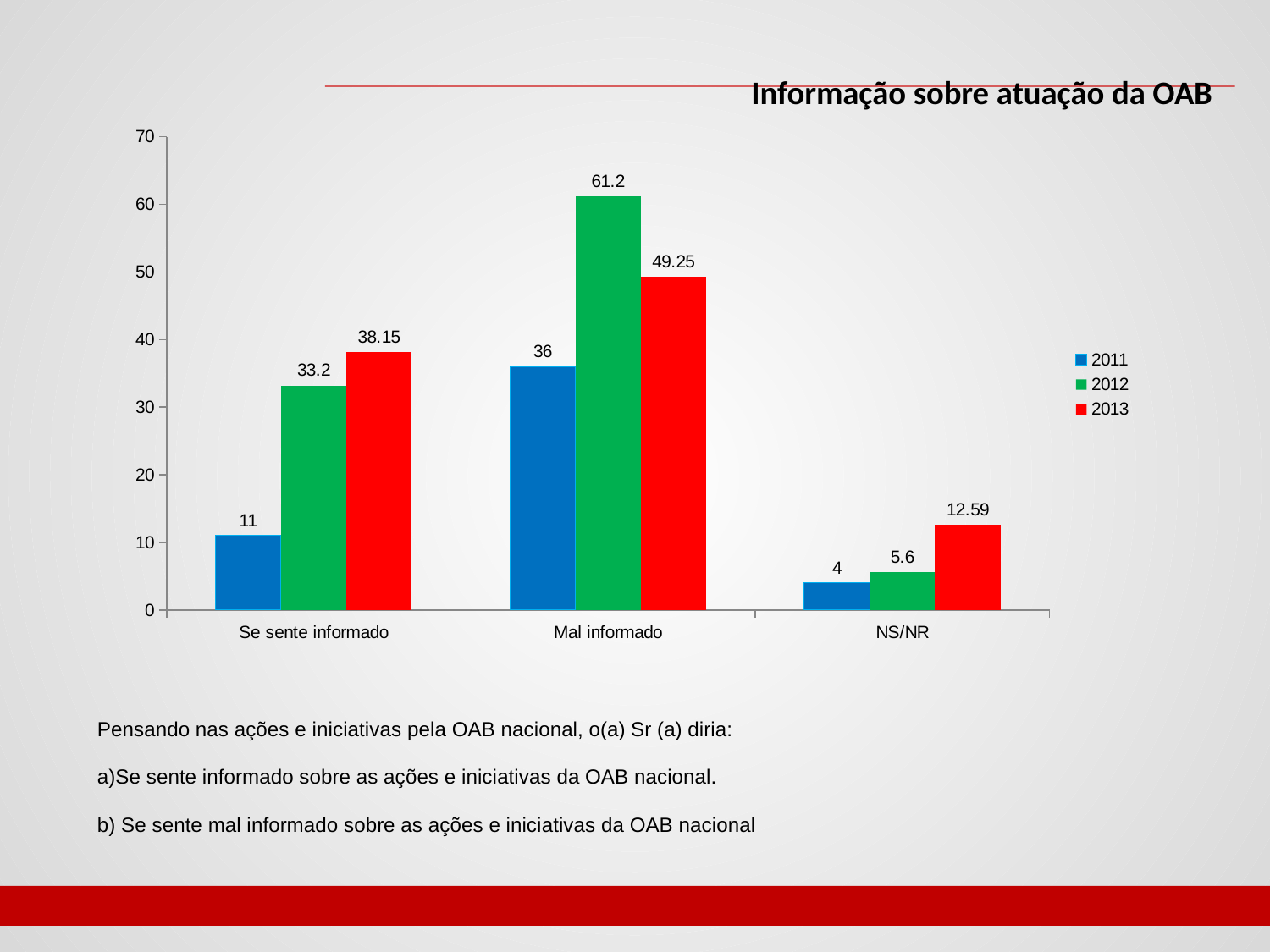
How many categories are shown on the x axis? 3 What kind of chart is shown on the slide? Bar chart Which is larger in the 'Se sente informado' category: the 2011 value or the 2012 value? 2012 Which category has the highest value for the 2011 series? Mal informado What is the difference between the 2012 and 2013 values in the 'Mal informado' category? 11.95 What is the value for 2011 in the 'NS/NR' category? 4 Which category has the lowest value for the 2013 series? NS/NR How many series does the legend list? 3 What is the title of the chart? Informação sobre atuação da OAB Is the value for 2013 in the 'NS/NR' category greater or less than 10? greater What is the value for 2012 in the 'Mal informado' category? 61.2 What is the value for 2013 in the 'Se sente informado' category? 38.15